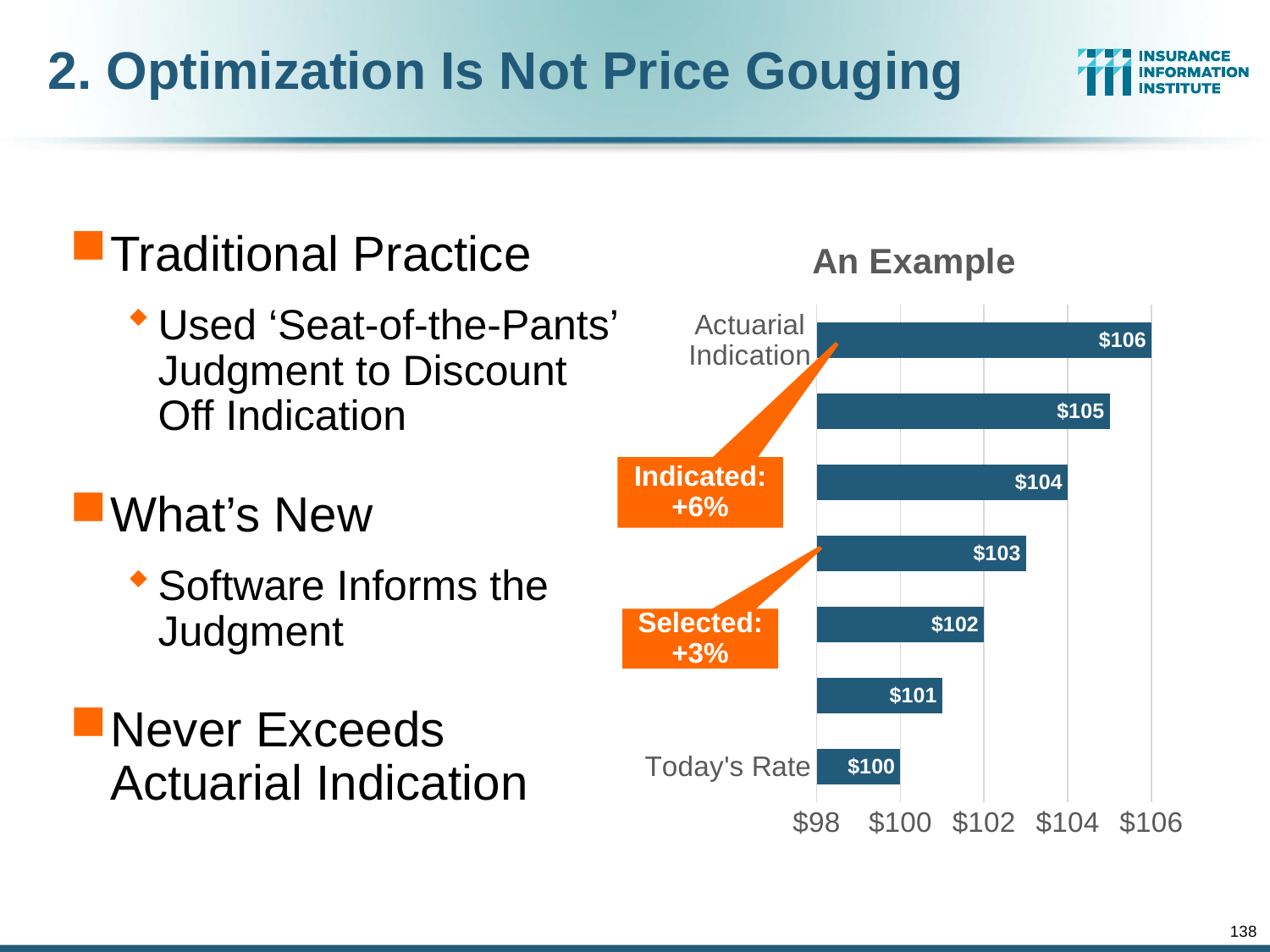
What is the value for Actuarial Indication in the chart? $106 What is the title of the chart? An Example Which category has the highest value in the chart? Actuarial Indication Which is larger, the value for Actuarial Indication or the value for Today's Rate? Actuarial Indication What is the difference between the Actuarial Indication value and Today's Rate? $6 What kind of chart is shown on the slide? Bar chart What is the value for Today's Rate in the chart? $100 Is the value for Actuarial Indication greater or less than $104? greater How many bars are plotted in the chart? 7 What percentage does the 'Selected' callout on the chart show? +3% Which category has the lowest value in the chart? Today's Rate What is the highest value printed on the chart's x axis? $106